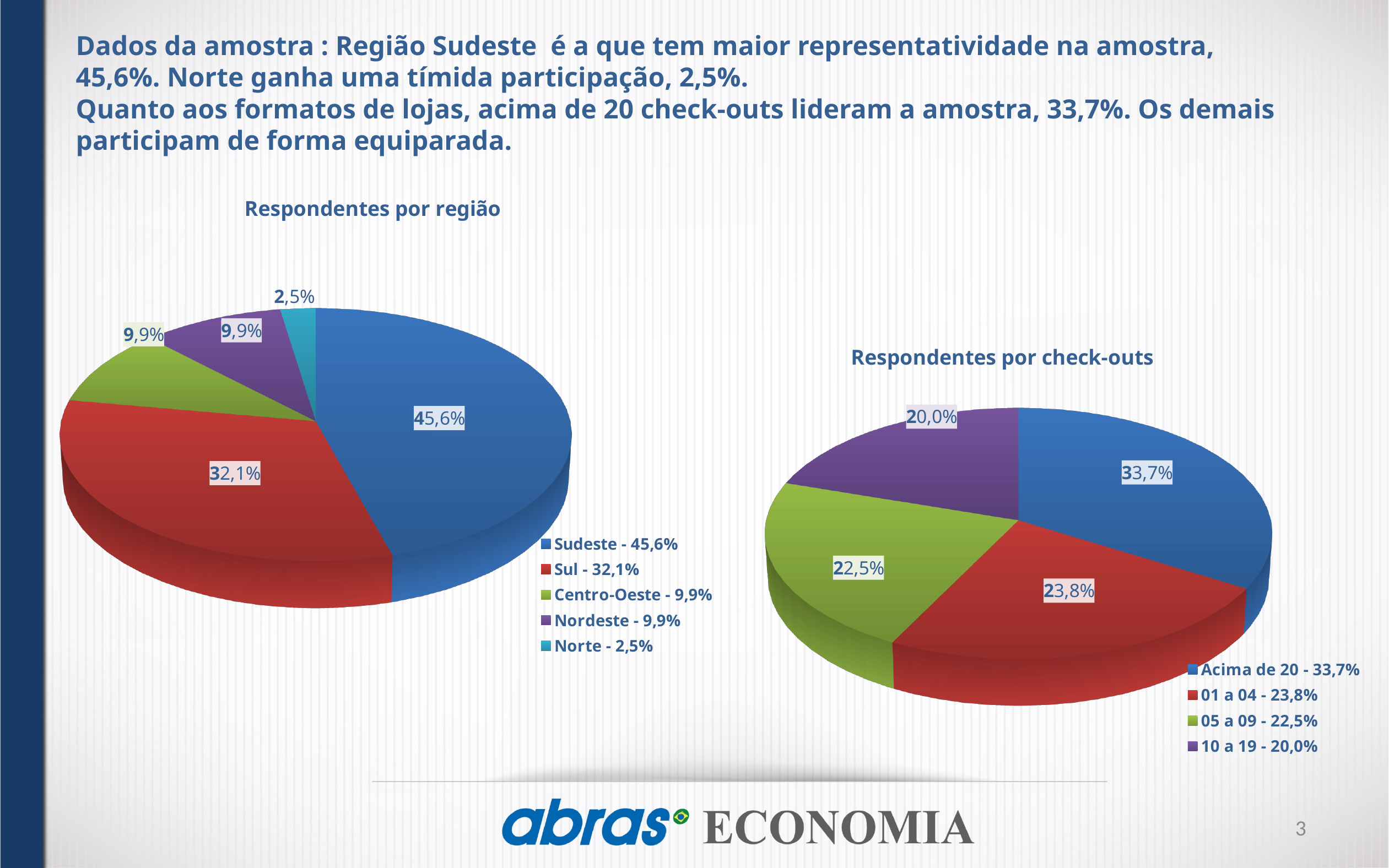
In the 'Respondentes por check-outs' chart, which category has the smallest slice? 10 a 19 In the 'Respondentes por check-outs' chart, what share does '05 a 09' have? 22,5% In the 'Respondentes por região' chart, what share does Sul have? 32,1% In the 'Respondentes por check-outs' chart, what is the difference between the 'Acima de 20' and '10 a 19' shares? 13,7% In the 'Respondentes por região' chart, which region has the smallest slice? Norte In the 'Respondentes por check-outs' chart, how many categories are shown? 4 In the 'Respondentes por check-outs' chart, which category has the largest slice? Acima de 20 What kind of chart is 'Respondentes por check-outs'? Pie chart In the 'Respondentes por região' chart, which region has the largest slice? Sudeste In the 'Respondentes por região' chart, what is the difference between the Sudeste and Sul shares? 13,5% In the 'Respondentes por região' chart, what share does Sudeste have? 45,6% In the 'Respondentes por região' chart, how many regions are shown? 5